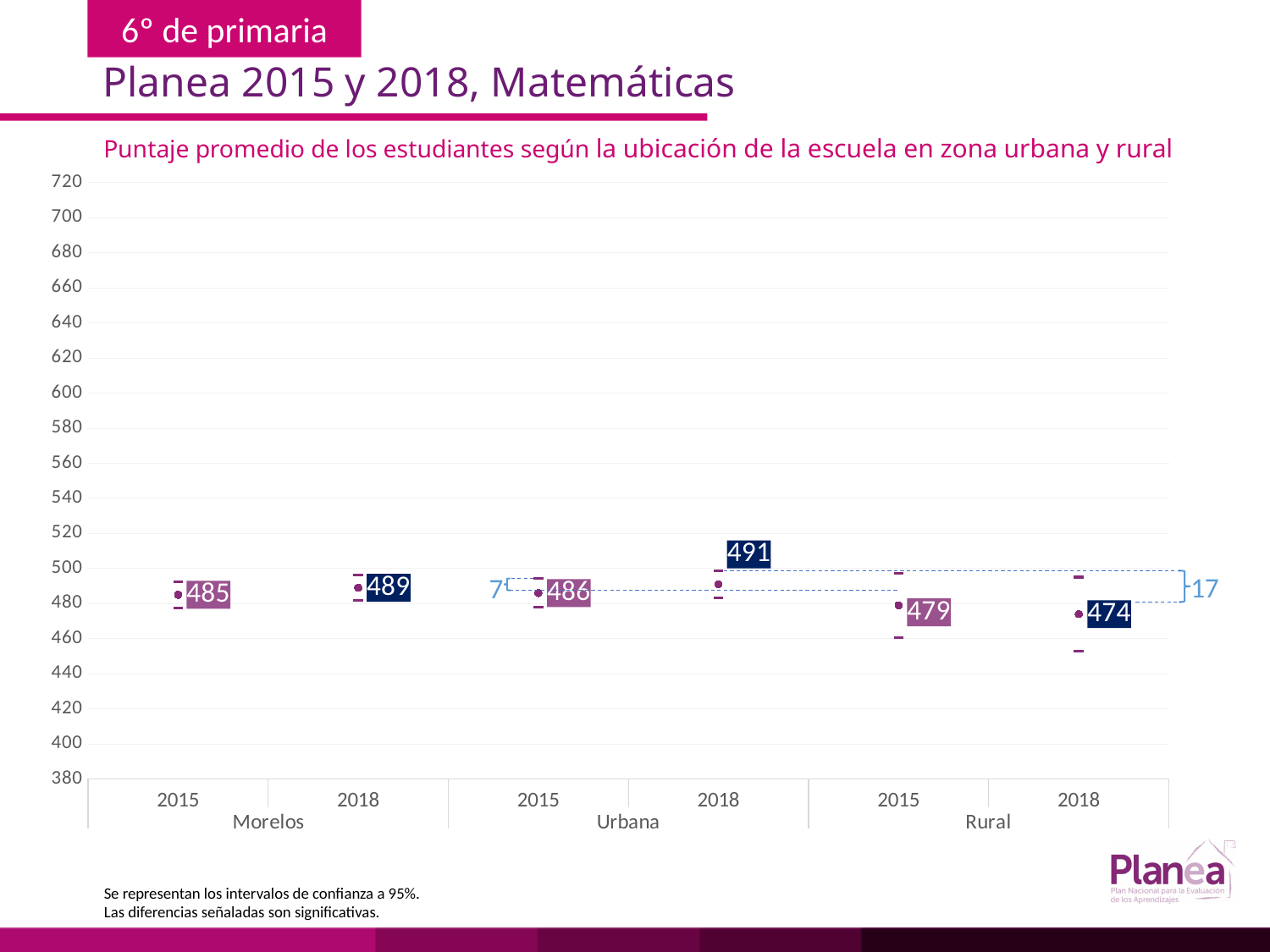
What is the average score for Rural in 2018? 474 What is the title of the chart? Puntaje promedio de los estudiantes según la ubicación de la escuela en zona urbana y rural What is the average score for Urbana in 2018? 491 What is the average score for Rural in 2015? 479 What is the average score for Morelos in 2018? 489 What is the difference between the Urbana 2015 score and the Rural 2015 score? 7 Which group and year has the lowest average score? Rural 2018 What is the difference between the Urbana 2018 score and the Rural 2018 score? 17 Which group and year has the highest average score? Urbana 2018 What is the average score for Morelos in 2015? 485 How many data points are plotted on the chart? 6 Which is larger, the Morelos 2018 score or the Rural 2018 score? Morelos 2018